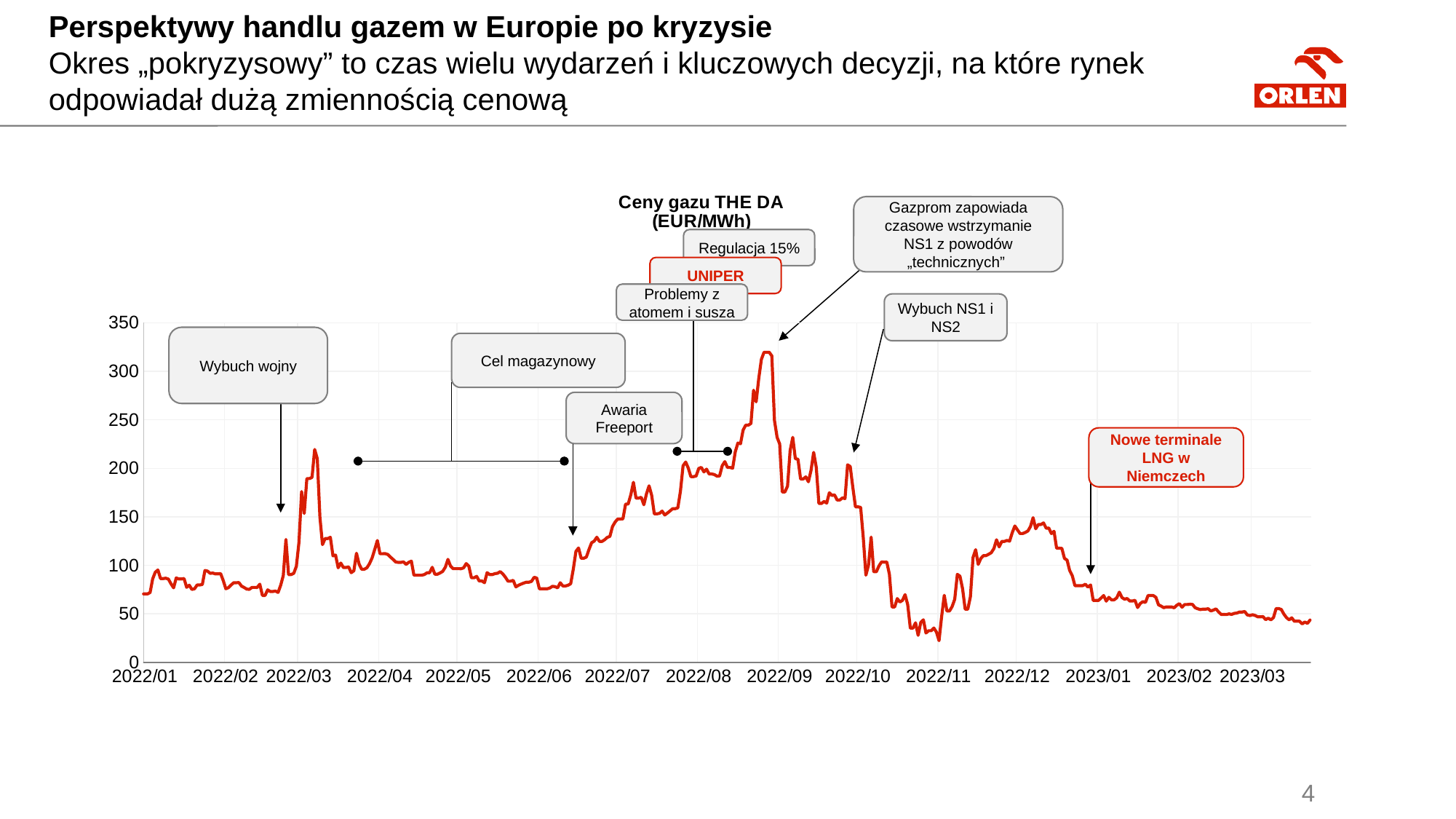
Is the value at the end of the series (after 2023/03) greater or less than 100? less Near which x-axis label does the line reach its highest point? 2022/09 Is the peak value of the line near 2022/09 greater or less than 300? greater Does the line rise or fall between its peak near 2022/09 and 2022/11? fall What colour is the price line in the chart? red Is the local peak near 2022/12 greater or less than 100? greater Near which x-axis label does the line reach its lowest point? 2022/11 What is the title of the chart? Ceny gazu THE DA (EUR/MWh) What kind of chart is shown on the slide? line chart